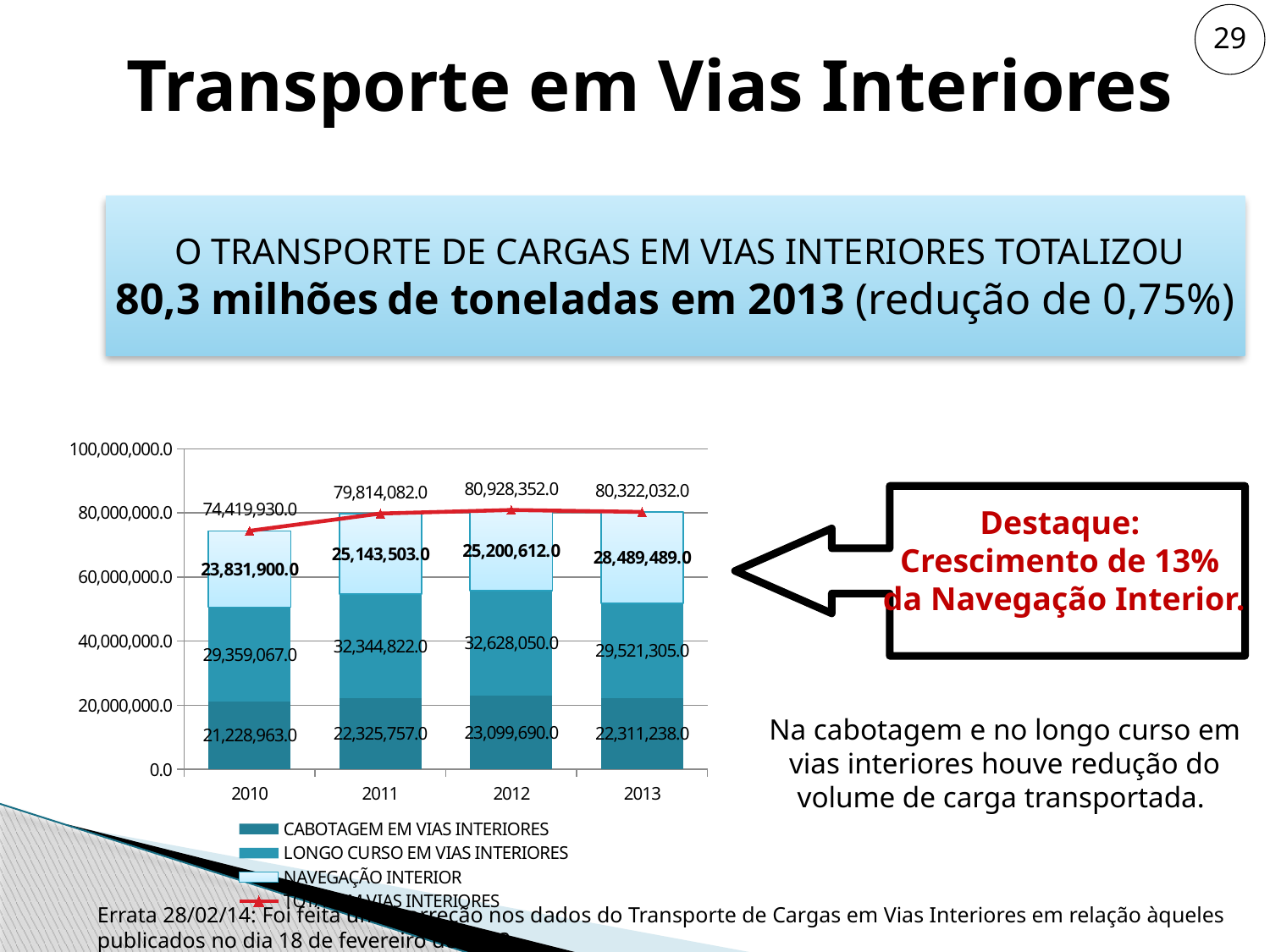
What is the total of the stacked bar for 2010? 74,419,930.0 What kind of chart is shown on the slide? Stacked bar chart with a line In which year is the total (TOTAL EM VIAS INTERIORES) lowest? 2010 In which year is the total (TOTAL EM VIAS INTERIORES) highest? 2012 How many years are shown on the x axis of the chart? 4 What is the value of NAVEGAÇÃO INTERIOR in 2013? 28,489,489.0 Which is larger in 2013: LONGO CURSO EM VIAS INTERIORES or NAVEGAÇÃO INTERIOR? LONGO CURSO EM VIAS INTERIORES What is the value of CABOTAGEM EM VIAS INTERIORES in 2010? 21,228,963.0 What is the value of LONGO CURSO EM VIAS INTERIORES in 2012? 32,628,050.0 How many series does the chart legend list? 4 What is the total shown for 2011? 79,814,082.0 What is the difference between the NAVEGAÇÃO INTERIOR value in 2013 and in 2012? 3,288,877.0